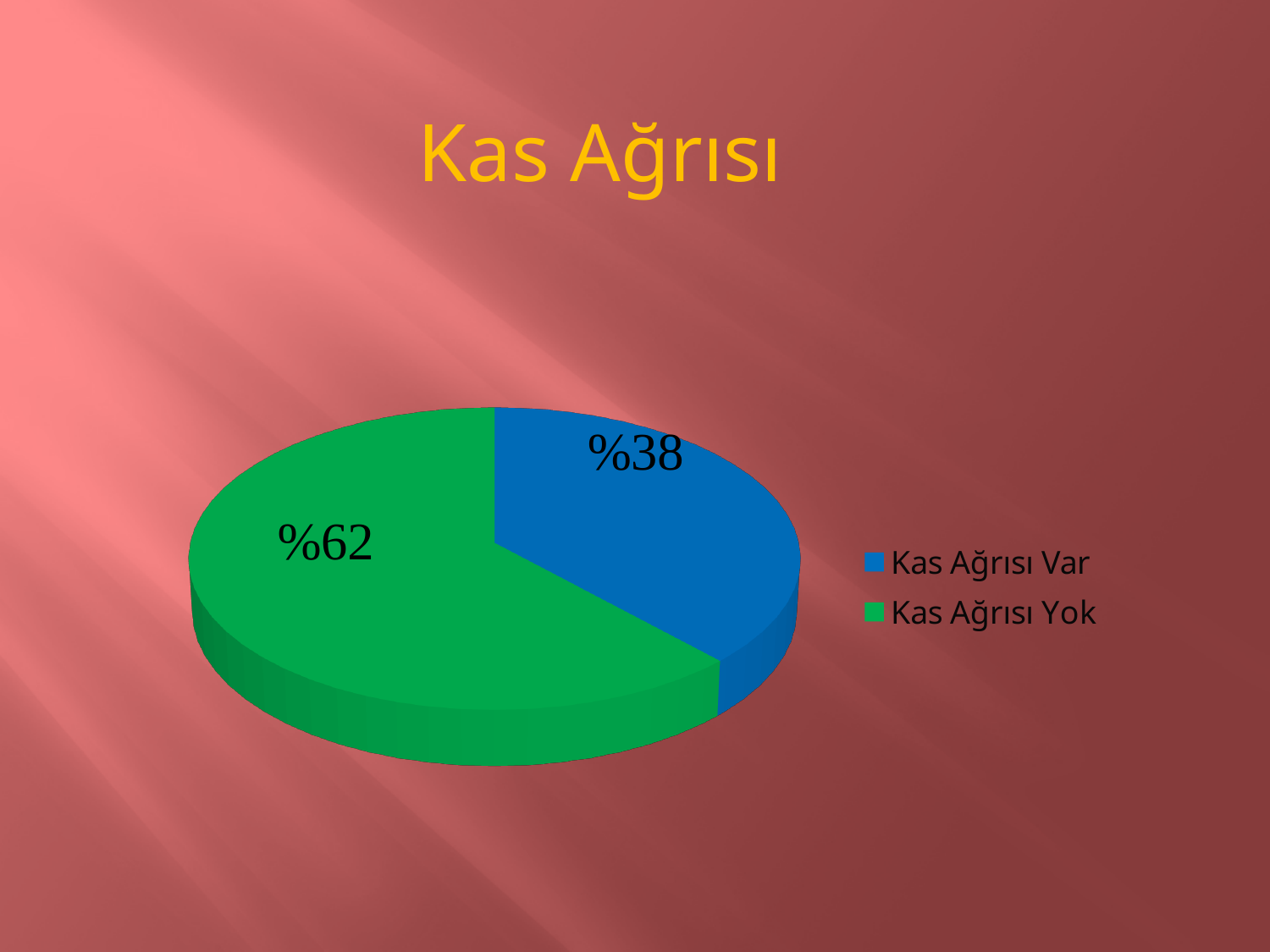
Which slice is the smallest? Kas Ağrısı Var What colour is the Kas Ağrısı Yok slice? green How many slices does the pie chart have? 2 Which slice is the largest? Kas Ağrısı Yok What is the title of the slide? Kas Ağrısı How many entries does the legend list? 2 What kind of chart is shown on the slide? pie chart Which is larger, Kas Ağrısı Var or Kas Ağrısı Yok? Kas Ağrısı Yok What is the difference between the Kas Ağrısı Yok and Kas Ağrısı Var values? %24 What is the value shown for Kas Ağrısı Var? %38 What share of the pie does Kas Ağrısı Var represent? %38 What is the value shown for Kas Ağrısı Yok? %62